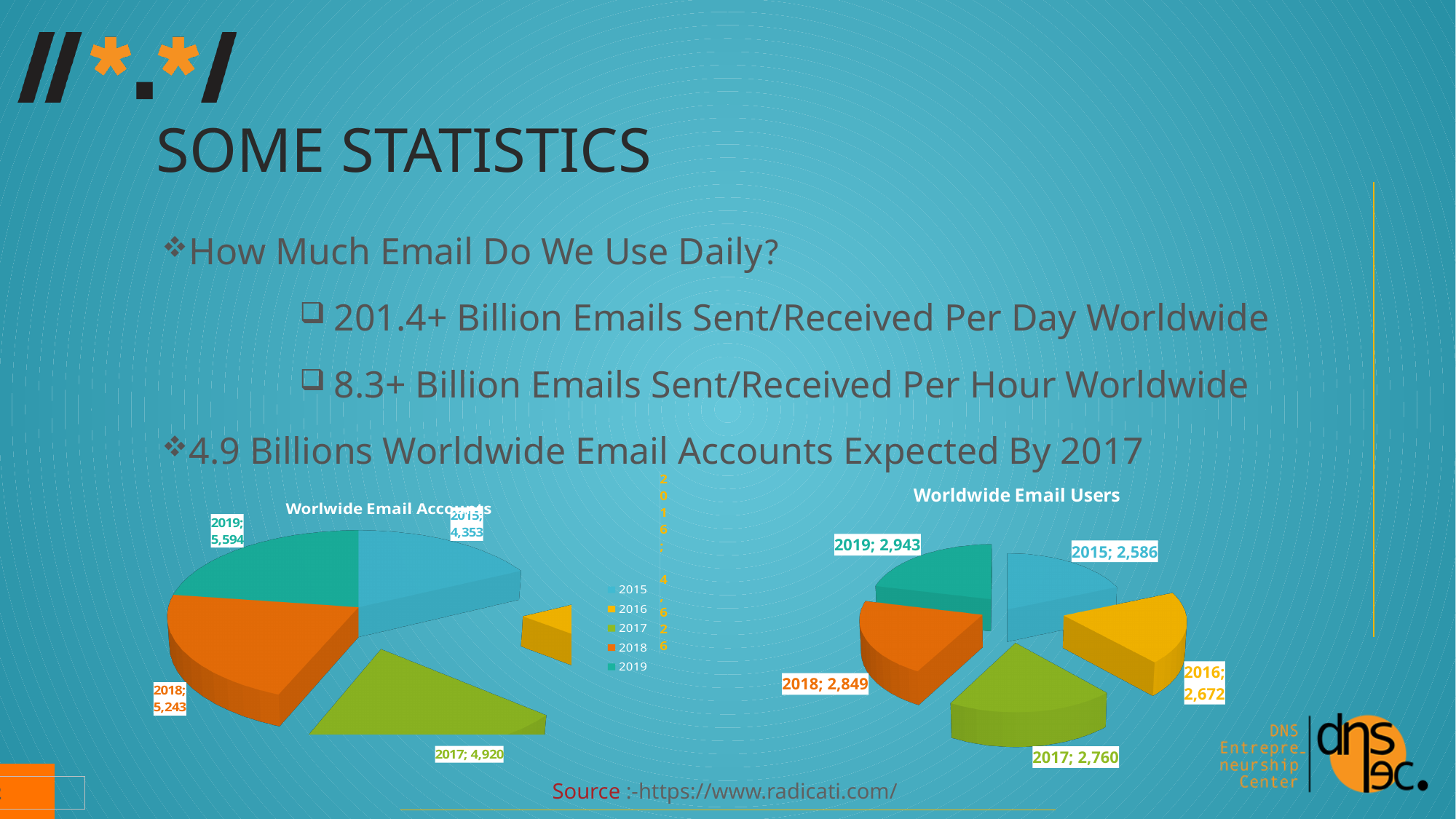
In the Worlwide Email Accounts chart, which year has the highest value? 2019 In the Worldwide Email Users chart, what is the value for 2019? 2,943 In the Worlwide Email Accounts chart, what is the difference between the 2019 and 2018 values? 351 How many years does the legend between the two charts list? 5 In the Worldwide Email Users chart, what is the difference between the 2019 and 2015 values? 357 In the Worlwide Email Accounts chart, what is the value for 2017? 4,920 In the Worlwide Email Accounts chart, what is the value for 2018? 5,243 In the Worldwide Email Users chart, what is the value for 2015? 2,586 In the Worldwide Email Users chart, which year has the highest value? 2019 In the Worldwide Email Users chart, which year has the lowest value? 2015 What kind of chart is the Worldwide Email Users chart? Pie chart In the Worldwide Email Users chart, which is larger, the value for 2017 or the value for 2018? 2018